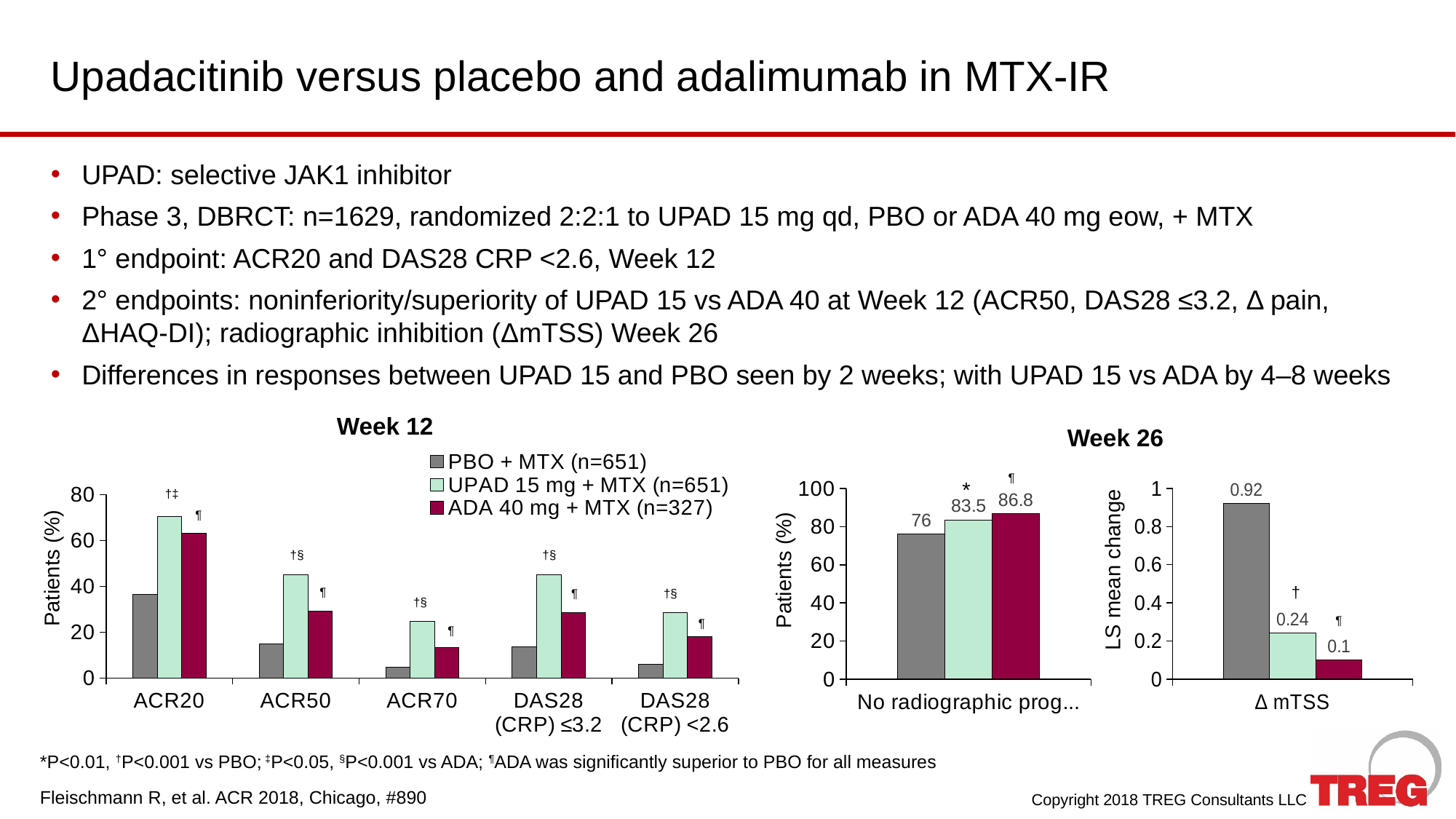
In the Week 12 chart, is the ACR70 value for PBO + MTX greater or less than 20? less In the Week 26 'No radiographic progression' chart, what is the value for PBO + MTX? 76 In the Week 26 'Δ mTSS' chart, what is the LS mean change for PBO + MTX? 0.92 In the Week 12 chart, which is larger for ACR50: UPAD 15 mg + MTX or ADA 40 mg + MTX? UPAD 15 mg + MTX What kind of chart is the Week 12 chart on the left? Bar chart In the Week 26 'No radiographic progression' chart, what is the difference between UPAD 15 mg + MTX and PBO + MTX? 7.5 In the Week 26 'No radiographic progression' chart, what is the value for ADA 40 mg + MTX? 86.8 How many series does the legend list for the Week 12 chart? 3 In the Week 12 chart, is the ACR20 value for UPAD 15 mg + MTX greater or less than 60? greater In the Week 26 'Δ mTSS' chart, which series has the lowest value? ADA 40 mg + MTX (n=327) In the Week 12 chart, which series has the highest value for ACR20? UPAD 15 mg + MTX (n=651) How many categories are shown on the x axis of the Week 12 chart? 5